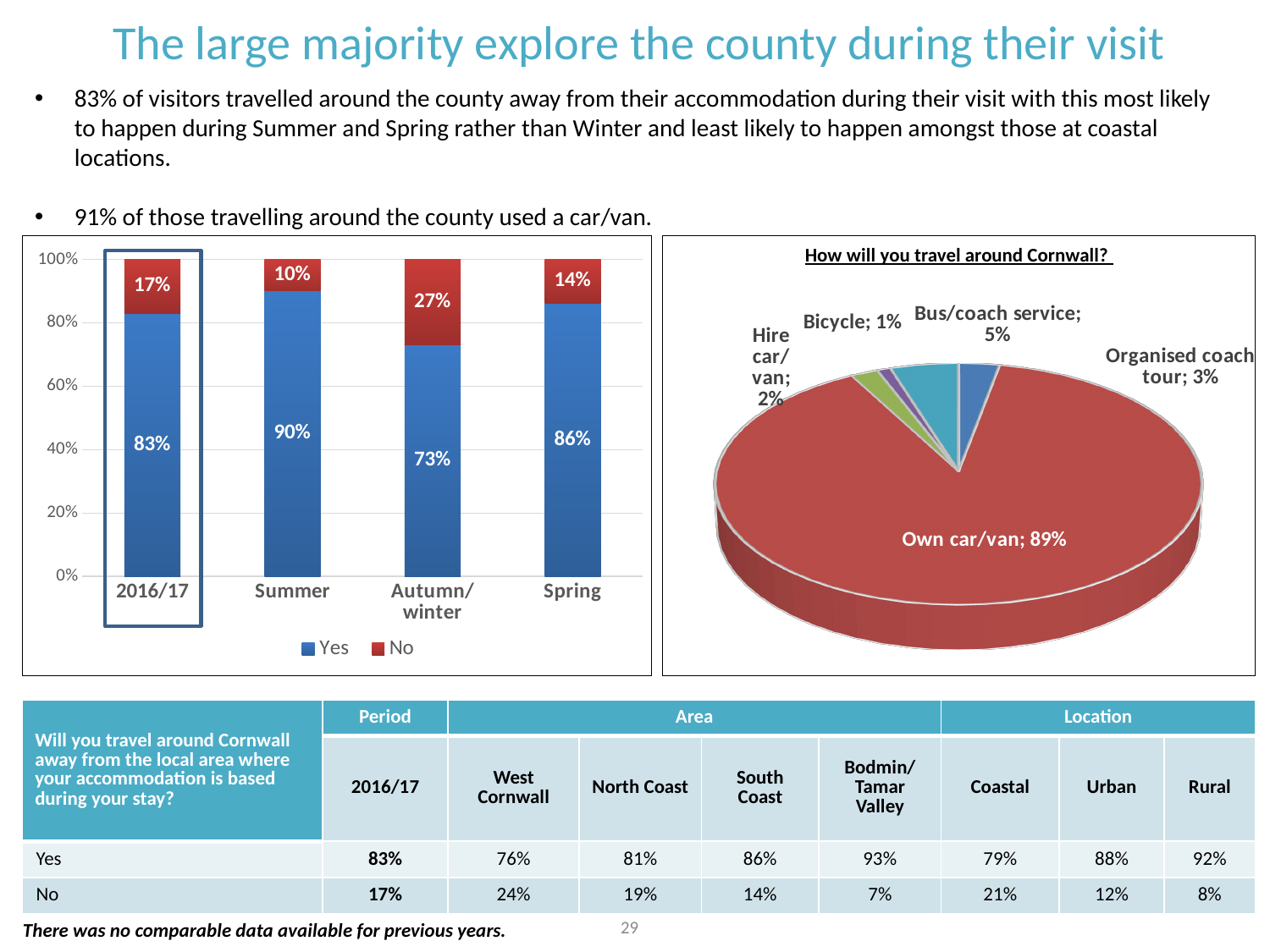
In the bar chart on the left, how many series does the legend list? 2 In the pie chart 'How will you travel around Cornwall?', what share is Own car/van? 89% In the bar chart on the left, which category has the highest 'Yes' value? Summer In the bar chart on the left, what is the 'Yes' value for Summer? 90% What kind of chart is the chart titled 'How will you travel around Cornwall?'? Pie chart In the pie chart 'How will you travel around Cornwall?', what is the difference between Bus/coach service and Organised coach tour? 2% In the pie chart 'How will you travel around Cornwall?', which slice is the smallest? Bicycle In the bar chart on the left, what is the difference between the 'Yes' values for Spring and Autumn/winter? 13% In the bar chart on the left, is the 'No' value larger for 2016/17 or for Spring? 2016/17 In the bar chart on the left, which category has the lowest 'Yes' value? Autumn/winter In the bar chart on the left, what is the 'No' value for Autumn/winter? 27% In the bar chart on the left, how many categories are shown on the x axis? 4